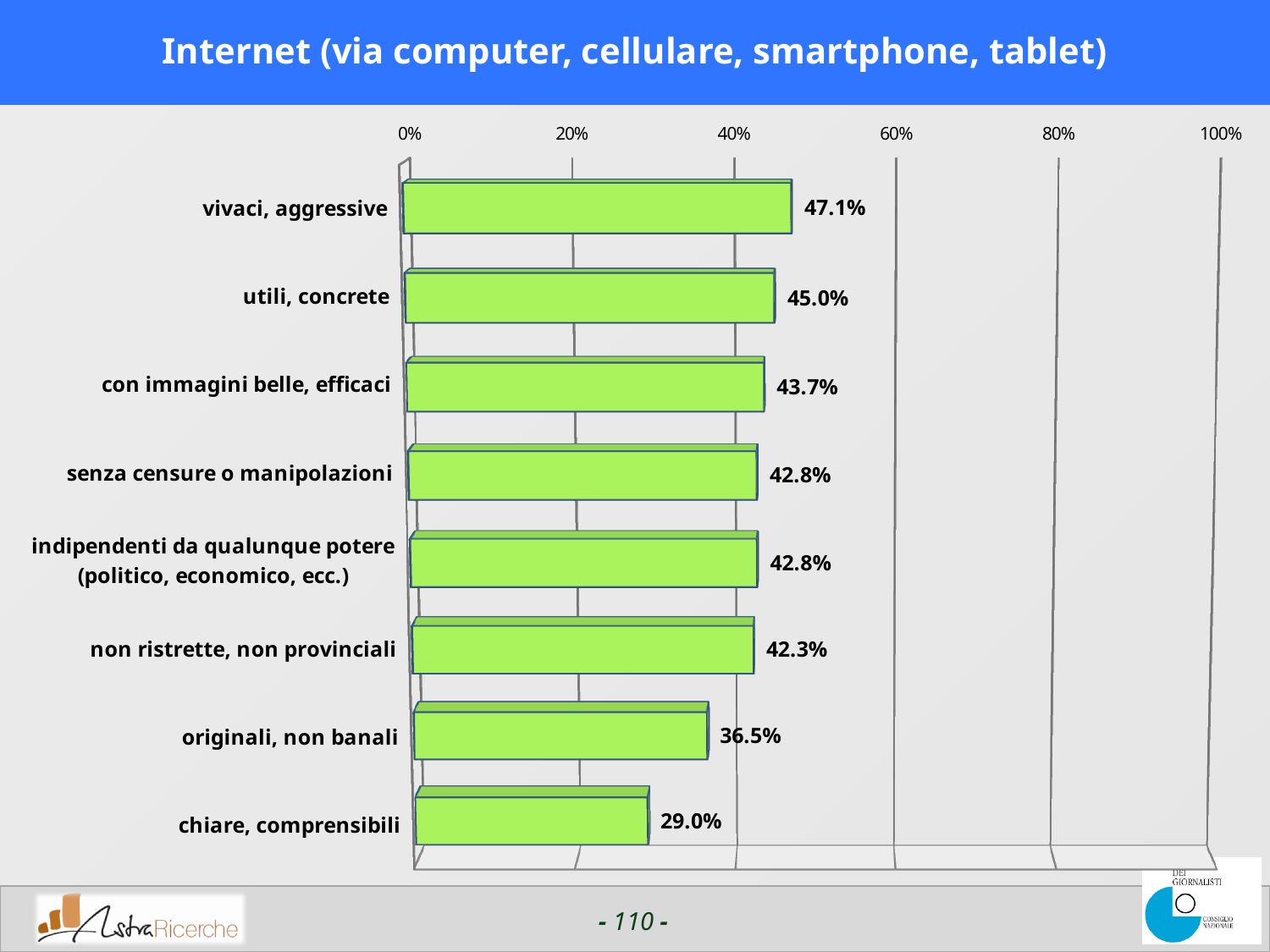
What is the value for "originali, non banali"? 36.5% What is the difference between the values for "vivaci, aggressive" and "chiare, comprensibili"? 18.1% Is the value for "non ristrette, non provinciali" greater or less than 40%? greater How many categories are shown in the chart? 8 What is the difference between the values for "utili, concrete" and "originali, non banali"? 8.5% Which category has the lowest value? chiare, comprensibili What is the value for "con immagini belle, efficaci"? 43.7% Which is larger, the value for "utili, concrete" or the value for "originali, non banali"? utili, concrete What is the value for "vivaci, aggressive"? 47.1% Which category has the highest value? vivaci, aggressive What kind of chart is shown on the slide? bar chart What is the value for "chiare, comprensibili"? 29.0%